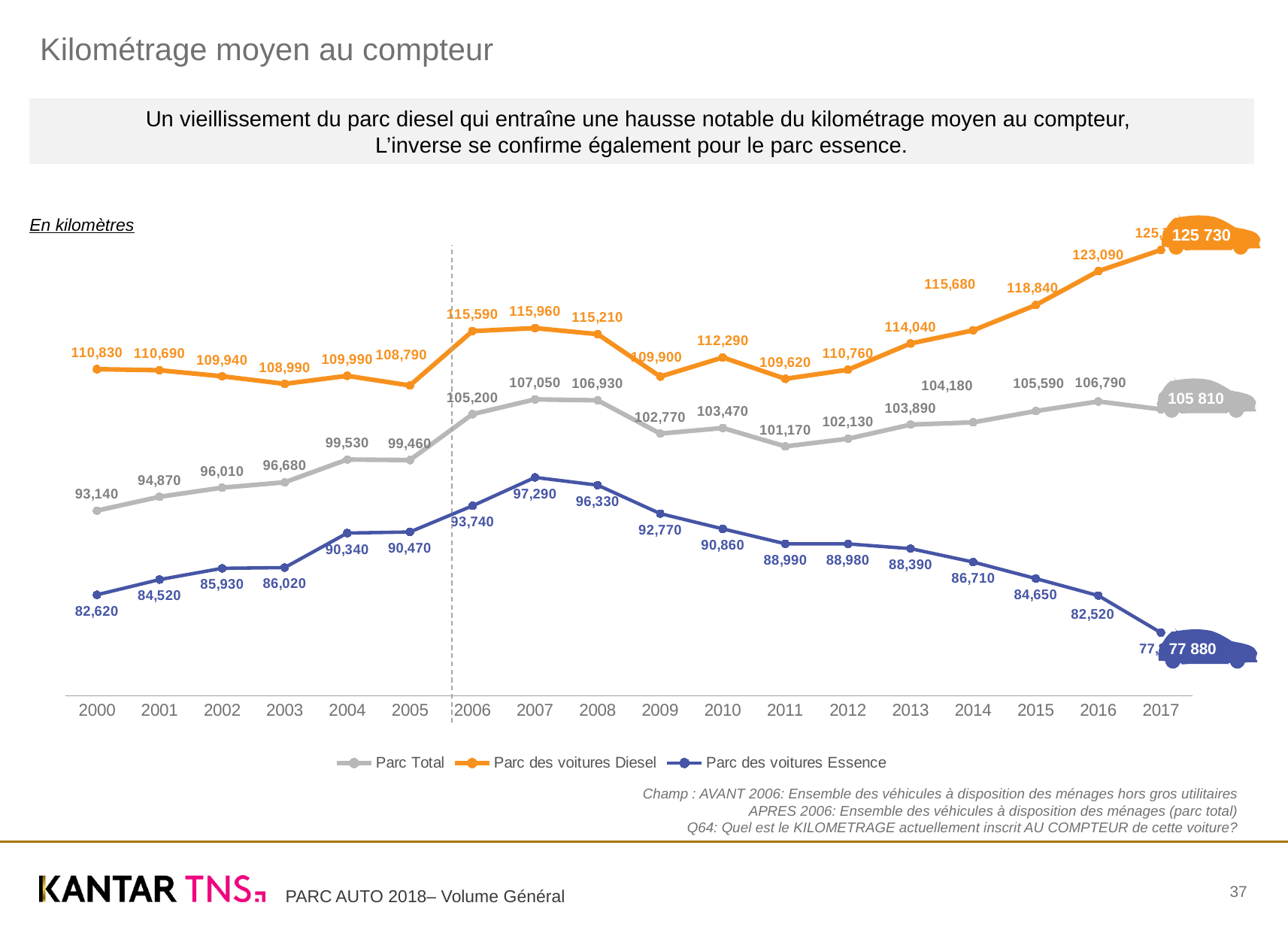
Which is larger in 2010: the Parc Total value or the Parc des voitures Essence value? Parc Total In which year does the Parc des voitures Essence series reach its lowest value? 2017 What is the value for Parc des voitures Essence in 2011? 88,990 Does the Parc des voitures Essence series rise or fall from 2007 to 2017? Fall What is the value for Parc Total in 2000? 93,140 How many years are plotted along the x axis? 18 In which year does the Parc des voitures Essence series reach its highest value? 2007 How many series does the legend list? 3 In which year does the Parc des voitures Diesel series reach its highest value? 2017 What kind of chart is shown on the slide? Line chart What is the value for Parc des voitures Diesel in 2007? 115,960 What is the difference between the Parc des voitures Diesel and Parc des voitures Essence values in 2017? 47,850